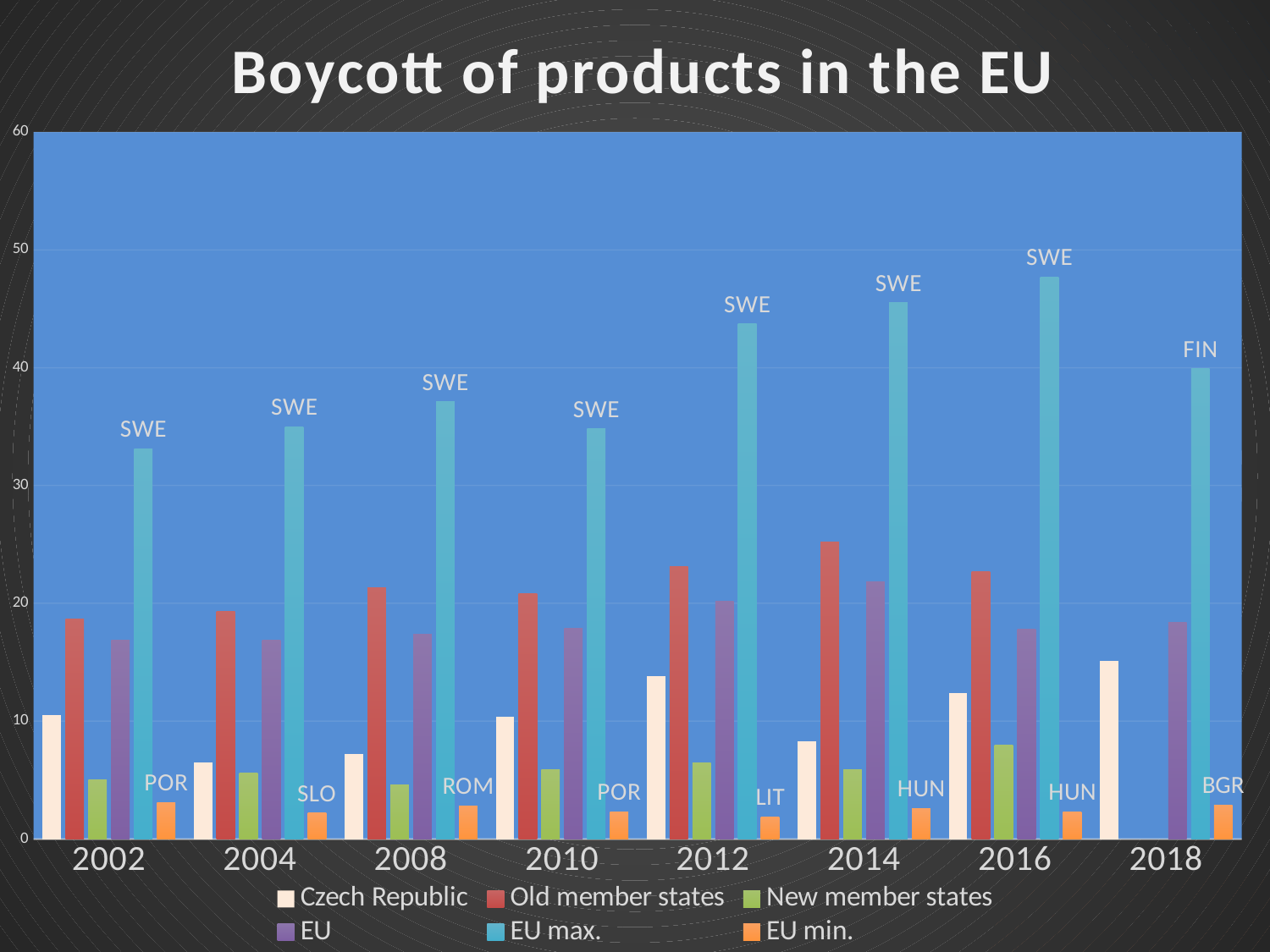
In which year is the EU max. bar the highest? 2016 How many series does the legend list? 6 Which country is labelled as the EU min. in 2008? ROM In which year is the EU max. bar the lowest? 2002 Is the value for Old member states in 2014 greater or less than 20? greater What kind of chart is shown on the slide? Bar chart How many years are shown on the x axis? 8 In which year is the Czech Republic bar the highest? 2018 Which country is labelled as the EU max. in 2018? FIN Which is larger in 2014, the Old member states bar or the EU bar? Old member states Is the value for EU max. in 2012 greater or less than 40? greater Which country is labelled as the EU min. in 2012? LIT